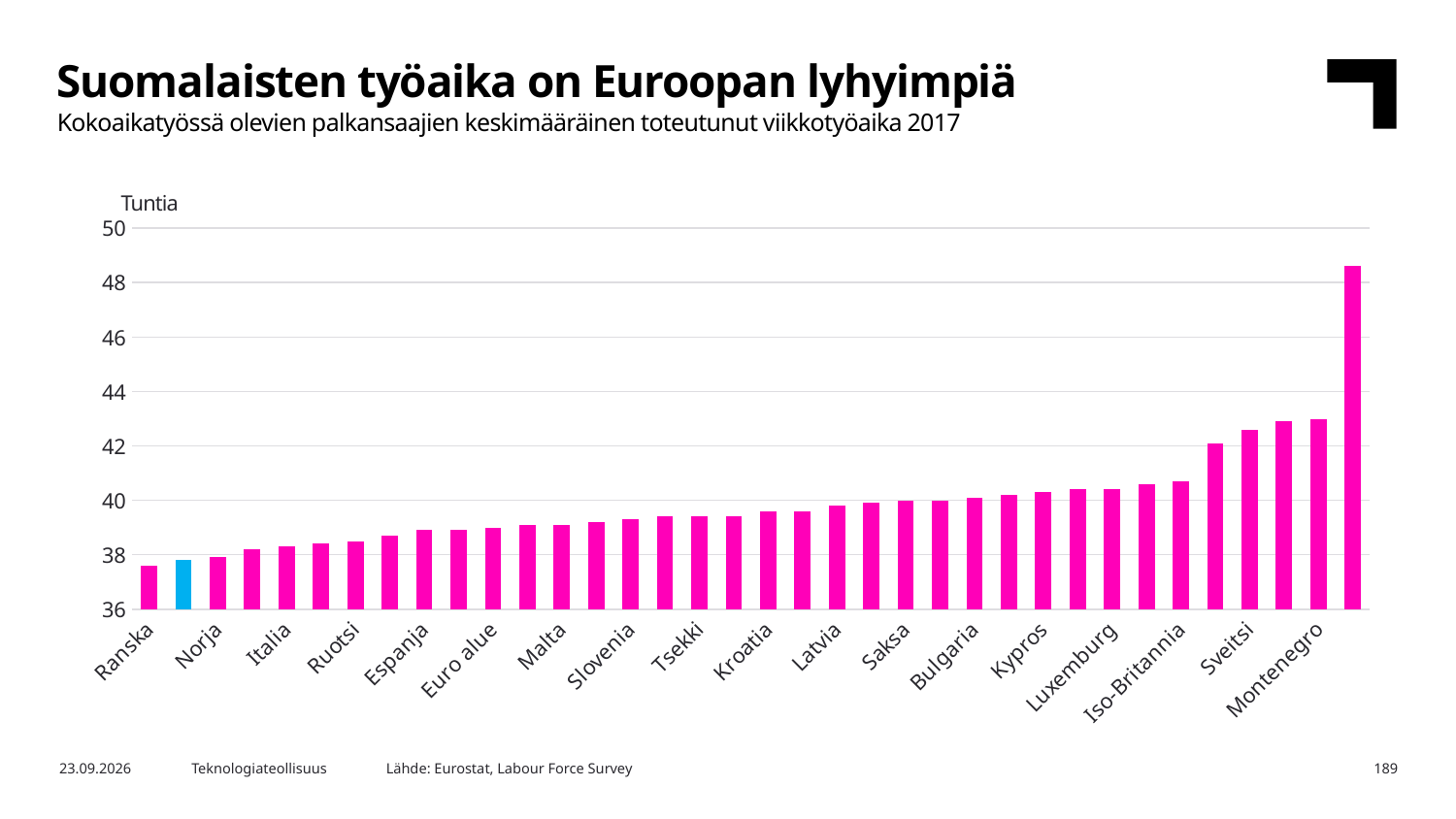
Is the value for Iso-Britannia greater or less than 40? greater Which has the larger value, Sveitsi or Ranska? Sveitsi Which has the larger value, Malta or Montenegro? Montenegro Is the value for Malta greater or less than 40? less Is the value for Espanja greater or less than 40? less What kind of chart is shown on the slide? bar chart Do the values rise or fall from left to right along the x axis? rise What unit is shown on the y axis of the chart? Tuntia